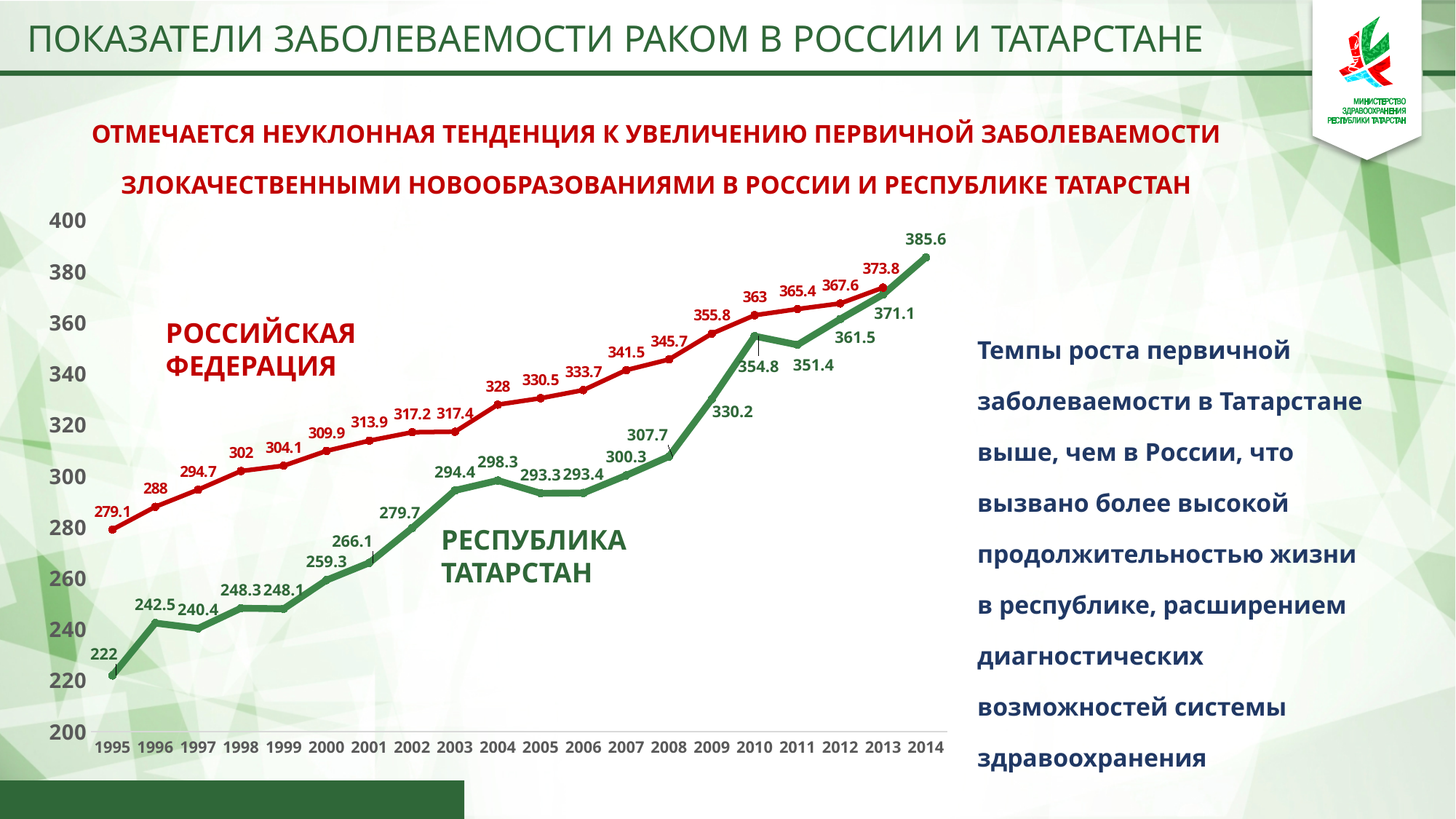
What is the value for Российская Федерация in 2013? 373.8 What is the value for Республика Татарстан in 2009? 330.2 What is the value for Российская Федерация in 1995? 279.1 Does the value for Российская Федерация generally rise or fall from 1995 to 2013? rise What is the difference between the Российская Федерация and Республика Татарстан values in 1995? 57.1 How many years are shown on the x axis? 20 In which year is the value for Республика Татарстан lowest? 1995 Which is larger in 2010: the value for Российская Федерация or for Республика Татарстан? Российская Федерация What is the value for Республика Татарстан in 2014? 385.6 In which year is the value for Российская Федерация highest? 2013 What type of chart is shown on the slide? line chart How many series are plotted on the chart? 2